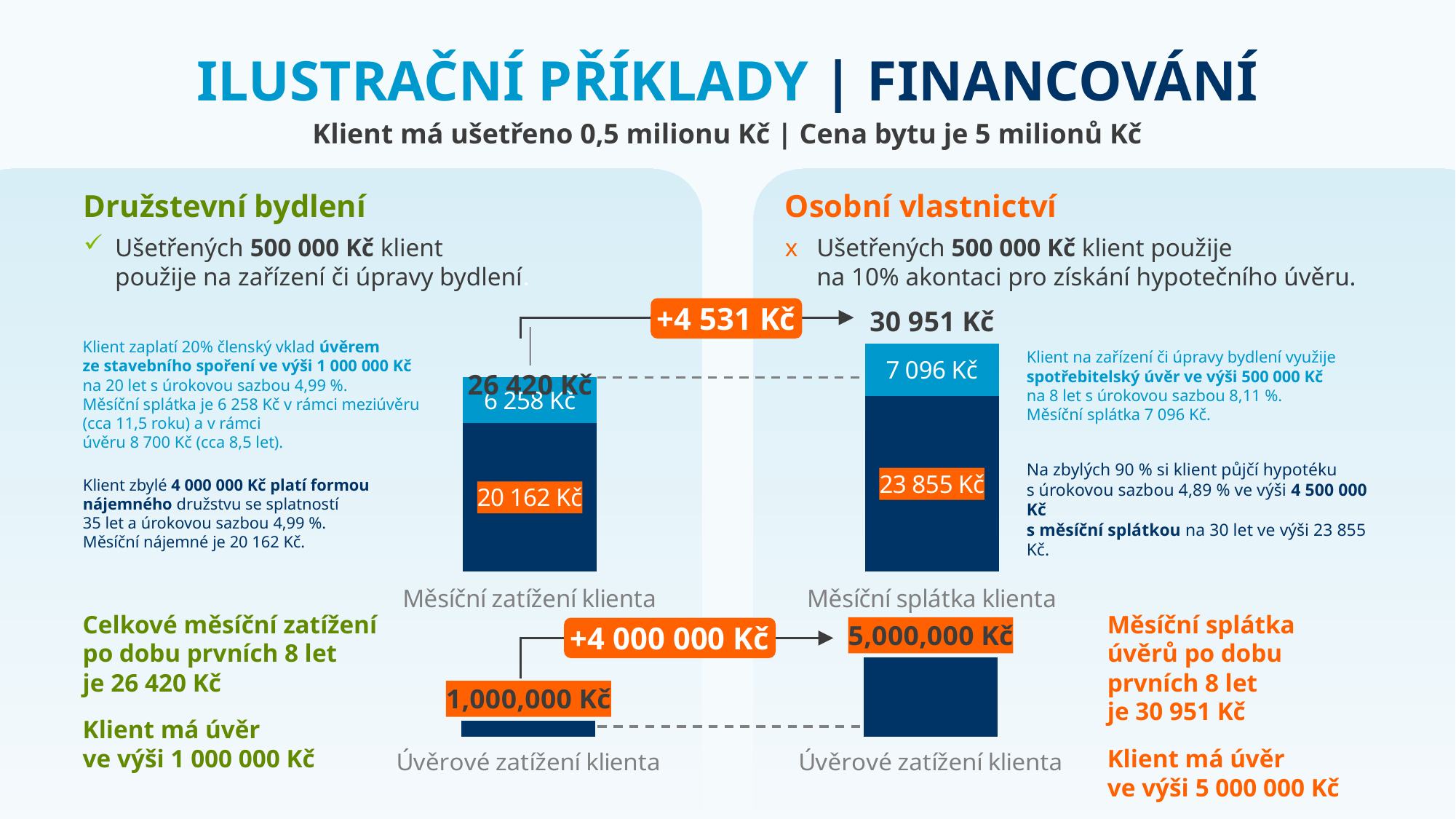
In the 'Měsíční splátka klienta' chart under Osobní vlastnictví, what is the value of the light blue segment? 7 096 Kč In the 'Měsíční splátka klienta' chart under Osobní vlastnictví, what is the value of the dark blue segment? 23 855 Kč What is the difference between the monthly total for Osobní vlastnictví (30 951 Kč) and the monthly total for Družstevní bydlení (26 420 Kč)? 4 531 Kč In the 'Úvěrové zatížení klienta' chart under Osobní vlastnictví, what is the value of the bar? 5,000,000 Kč Which is larger: the monthly total for Družstevní bydlení or the monthly total for Osobní vlastnictví? Osobní vlastnictví In the 'Měsíční zatížení klienta' chart under Družstevní bydlení, what is the value of the light blue segment? 6 258 Kč What is the total of the stacked bar in the 'Měsíční zatížení klienta' chart under Družstevní bydlení? 26 420 Kč In the 'Měsíční zatížení klienta' chart under Družstevní bydlení, what is the value of the dark blue segment? 20 162 Kč What is the difference between the loan burden bars for Osobní vlastnictví (5,000,000 Kč) and Družstevní bydlení (1,000,000 Kč)? 4 000 000 Kč What is the total of the stacked bar in the 'Měsíční splátka klienta' chart under Osobní vlastnictví? 30 951 Kč What kind of chart is used for 'Měsíční zatížení klienta' under Družstevní bydlení? Stacked bar chart In the 'Úvěrové zatížení klienta' chart under Družstevní bydlení, what is the value of the bar? 1,000,000 Kč